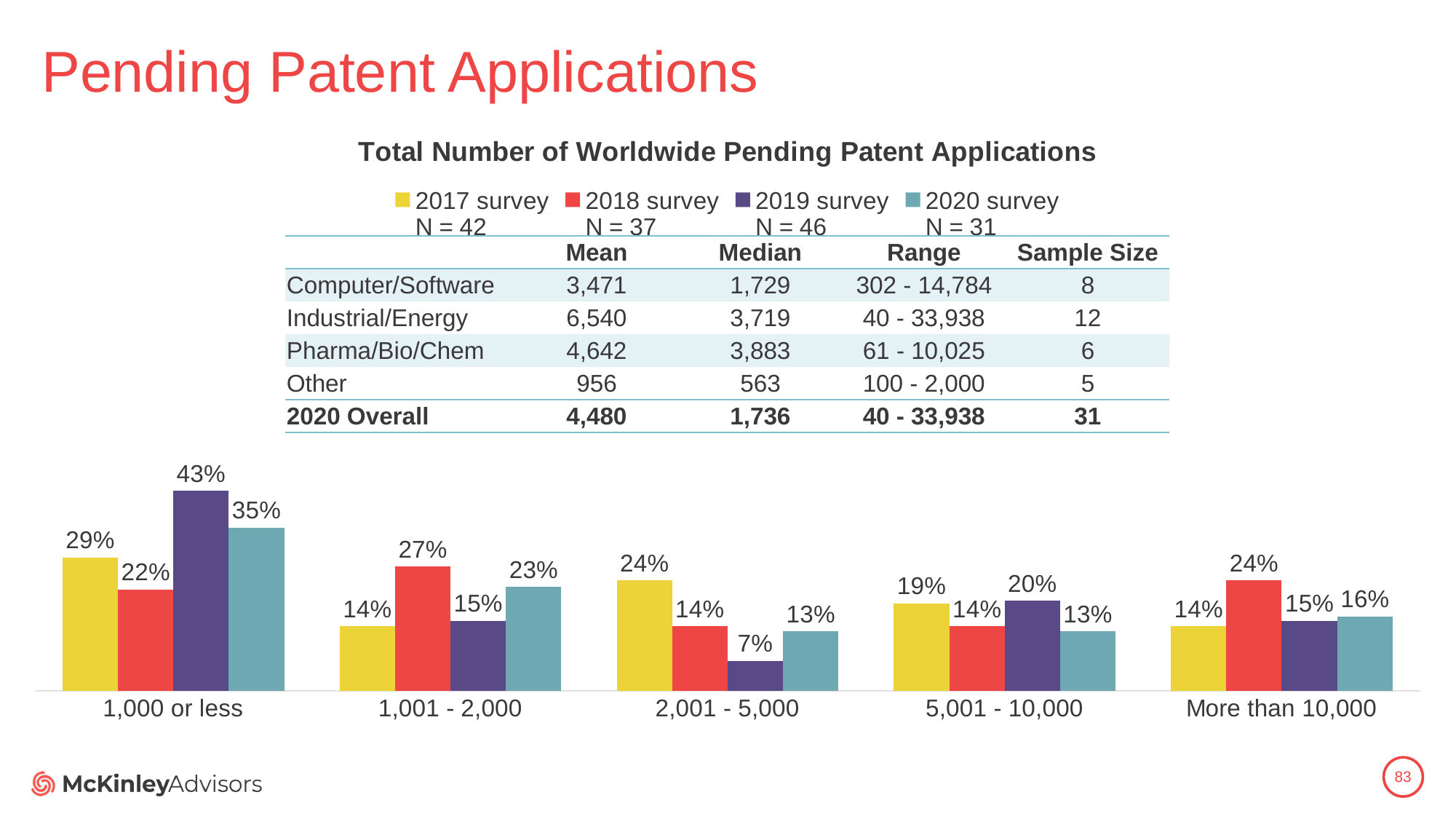
How many series does the chart legend list? 4 What is the 2020 survey value for the 'More than 10,000' category? 16% What is the sample size (N) for the 2020 survey shown in the legend? N = 31 What is the 2018 survey value for the '1,001 - 2,000' category? 27% What is the 2019 survey value for the '1,000 or less' category? 43% Which category has the lowest 2019 survey value? 2,001 - 5,000 How many categories are shown along the x axis of the bar chart? 5 In the '2,001 - 5,000' category, which is larger: the 2017 survey value or the 2020 survey value? 2017 survey What kind of chart is shown on the slide? bar chart Which category has the highest 2017 survey value? 1,000 or less What is the difference between the 2019 survey and 2018 survey values for the '1,000 or less' category? 21% What is the difference between the 2018 survey and 2017 survey values for the 'More than 10,000' category? 10%